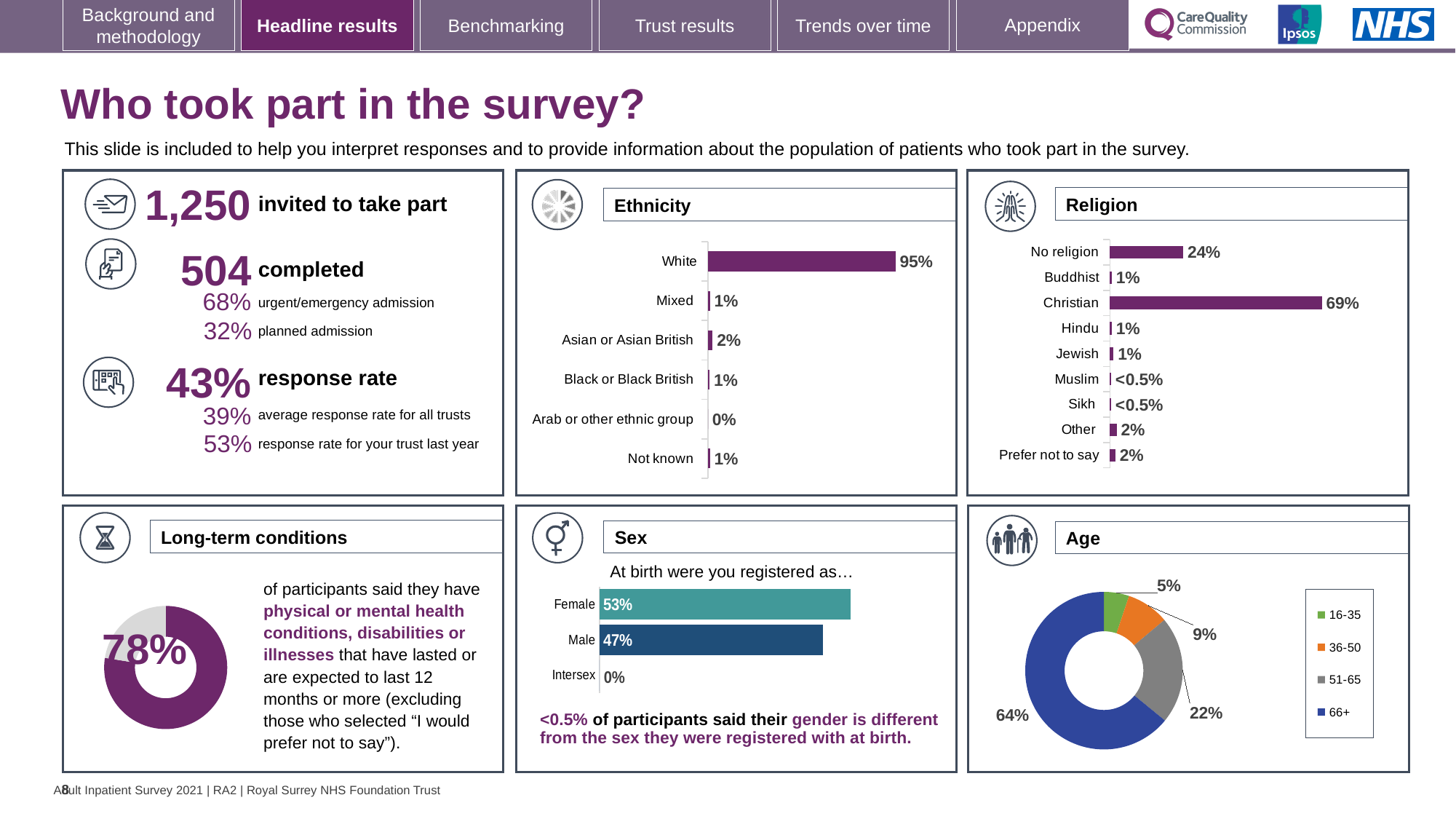
In the Religion chart, what is the difference between the Christian and No religion percentages? 45% In the Religion chart, what is the value shown for Muslim? <0.5% In the Ethnicity chart, what is the value for Asian or Asian British? 2% In the Ethnicity chart, what percentage of participants were White? 95% In the Age chart, what share of participants were aged 66+? 64% In the Sex chart, what is the difference between the Female and Male percentages? 6% What kind of chart is used in the Age panel? Donut chart How many ethnic group categories are shown in the Ethnicity chart? 6 How many age groups does the legend of the Age chart list? 4 In the Ethnicity chart, which ethnic group has the highest percentage? White In the Religion chart, what percentage of participants were Christian? 69% In the Sex chart, which is larger, the Female or the Male percentage? Female